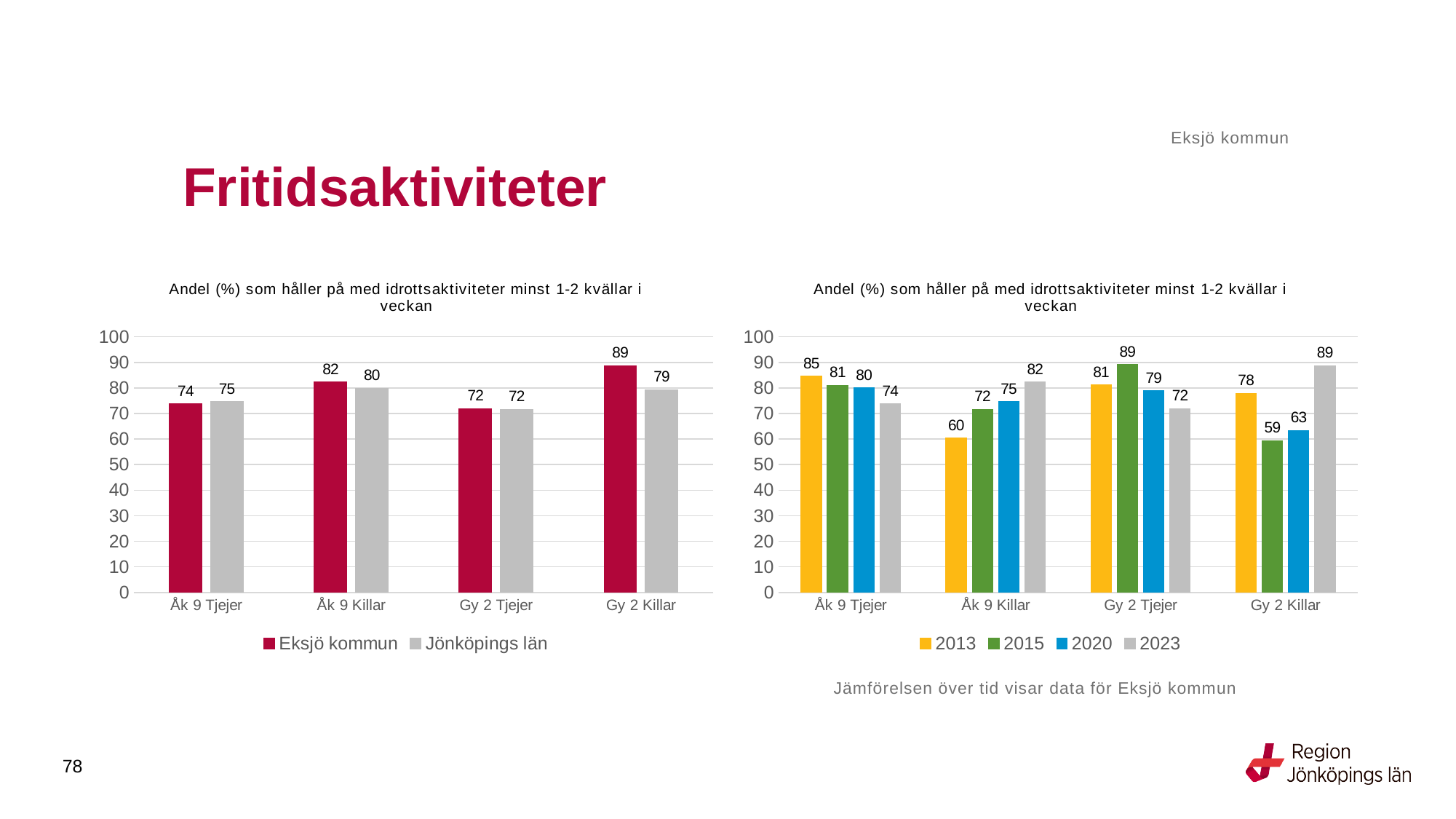
In the right chart, what is the value for 2013 for Åk 9 Killar? 60 In the left chart, how many series does the legend list? 2 In the left chart, what is the value for Eksjö kommun for Gy 2 Killar? 89 In the right chart, what is the difference between the 2013 and 2023 values for Åk 9 Tjejer? 11 In the left chart, what is the difference between Eksjö kommun and Jönköpings län for Gy 2 Killar? 10 In the left chart, which category has the lowest value for Eksjö kommun? Gy 2 Tjejer In the right chart, is the value for 2015 for Gy 2 Killar larger or smaller than the value for 2023 for Gy 2 Killar? smaller What kind of chart is the right chart? Bar chart In the right chart, what is the value for 2020 for Gy 2 Killar? 63 In the right chart, how many series does the legend list? 4 In the left chart, what is the value for Jönköpings län for Åk 9 Killar? 80 In the right chart, which year has the highest value for Gy 2 Tjejer? 2015